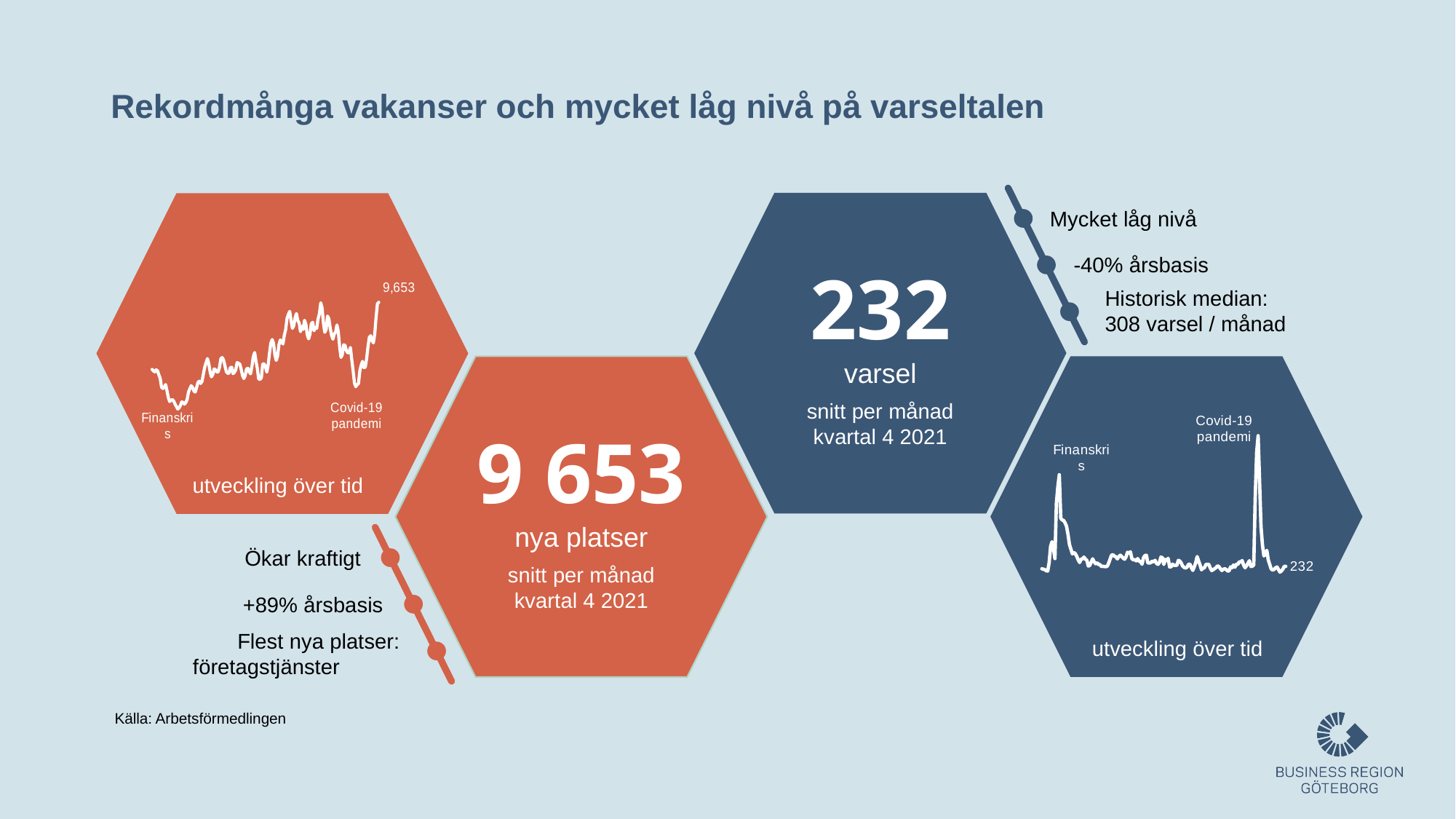
How many lines (series) are plotted in the right blue hexagon chart? 1 Which two events are annotated on the line in the left orange hexagon chart? Finanskris and Covid-19 pandemi In the left orange hexagon chart, does the line overall rise or fall from its start to its end? rise In the right blue hexagon chart, what value is printed at the end of the line? 232 In the right blue hexagon chart, does the line fall or rise after the Covid-19 pandemi peak? fall What is the caption printed below the line in the right blue hexagon chart? utveckling över tid How many lines (series) are plotted in the left orange hexagon chart? 1 In the left orange hexagon chart, what value is printed at the end of the line? 9,653 What kind of chart is shown in the right blue hexagon labelled "utveckling över tid"? line chart What kind of chart is shown in the left orange hexagon labelled "utveckling över tid"? line chart In the right blue hexagon chart, which annotated event shows the higher peak: Finanskris or Covid-19 pandemi? Covid-19 pandemi